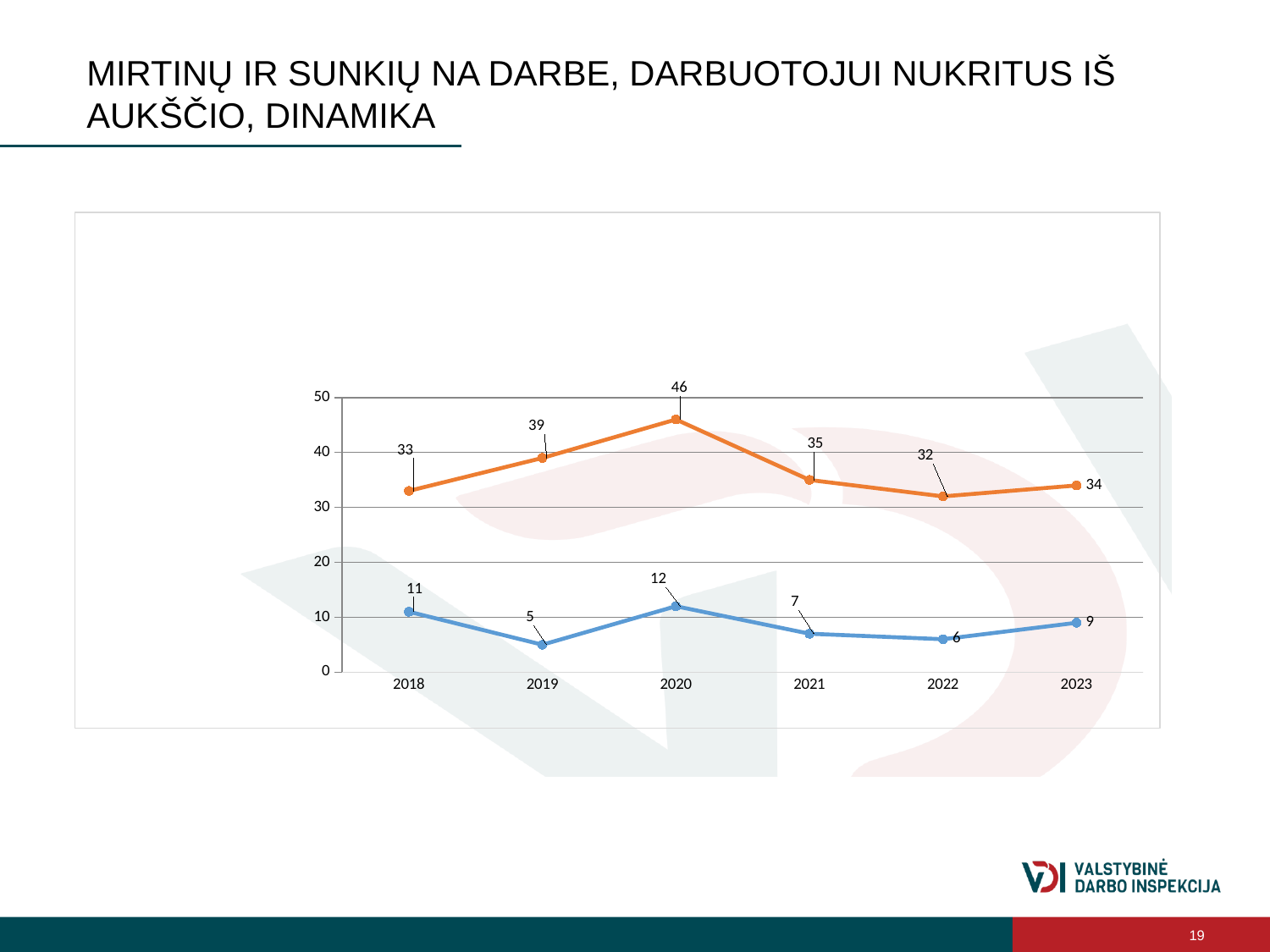
How many years are shown on the x axis? 6 What is the value of the orange line in 2020? 46 What is the value of the blue line in 2019? 5 Does the orange line rise or fall from 2020 to 2022? Fall How many lines are plotted on the chart? 2 In which year does the blue line have its lowest value? 2019 What is the value of the orange line in 2023? 34 What is the difference between the blue line's values in 2018 and 2023? 2 In which year does the orange line reach its highest value? 2020 What is the difference between the orange line's values in 2020 and 2022? 14 Which is larger: the orange line's value in 2019 or in 2021? 2019 What kind of chart is shown on the slide? Line chart